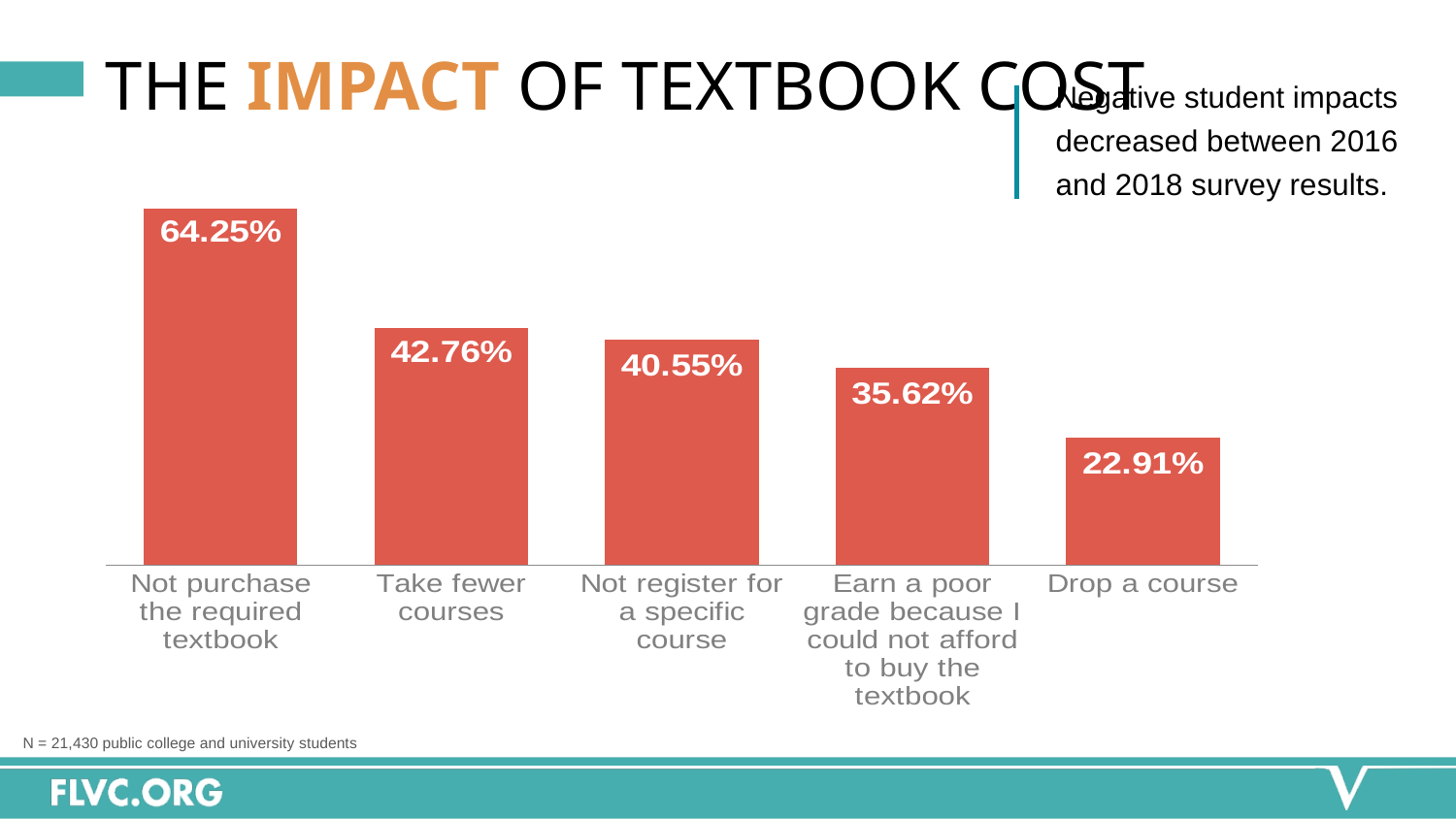
What is the value for 'Take fewer courses'? 42.76% Which category has the highest value? Not purchase the required textbook What percentage of students reported they would not purchase the required textbook? 64.25% What is the value for 'Not register for a specific course'? 40.55% Which category has the lowest value? Drop a course What is the difference between 'Not purchase the required textbook' and 'Drop a course'? 41.34% Which is larger: 'Earn a poor grade because I could not afford to buy the textbook' or 'Drop a course'? Earn a poor grade because I could not afford to buy the textbook What is the difference between 'Take fewer courses' and 'Not register for a specific course'? 2.21% Do the values rise or fall from left to right across the categories? Fall What percentage of students said they would drop a course? 22.91% How many categories are shown in the chart? 5 What kind of chart is shown on the slide? Bar chart